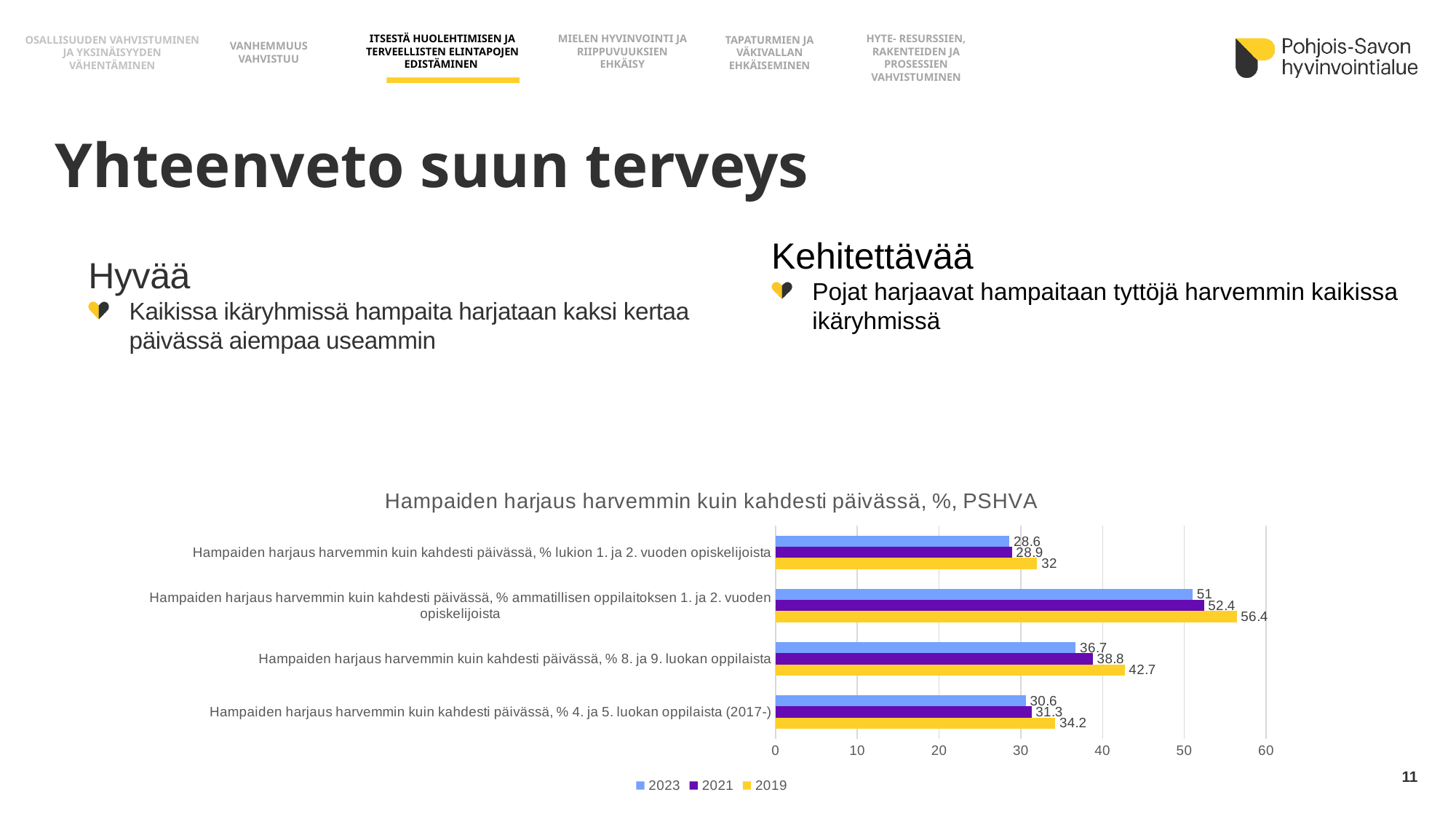
What is the 2021 value for 'lukion 1. ja 2. vuoden opiskelijoista'? 28.9 What is the title of the chart? Hampaiden harjaus harvemmin kuin kahdesti päivässä, %, PSHVA What type of chart is shown on the slide? Bar chart What is the 2023 value for 'ammatillisen oppilaitoksen 1. ja 2. vuoden opiskelijoista'? 51 What is the difference between the 2019 and 2023 values for 'ammatillisen oppilaitoksen 1. ja 2. vuoden opiskelijoista'? 5.4 For '4. ja 5. luokan oppilaista (2017-)', which is larger: the 2019 value or the 2023 value? 2019 How many series does the chart legend list? 3 Is the 2021 value for '8. ja 9. luokan oppilaista' greater or less than 40? less Which category has the highest 2019 value? Ammatillisen oppilaitoksen 1. ja 2. vuoden opiskelijoista What is the 2019 value for '8. ja 9. luokan oppilaista'? 42.7 How many categories are shown in the chart? 4 Which category has the lowest 2023 value? Lukion 1. ja 2. vuoden opiskelijoista